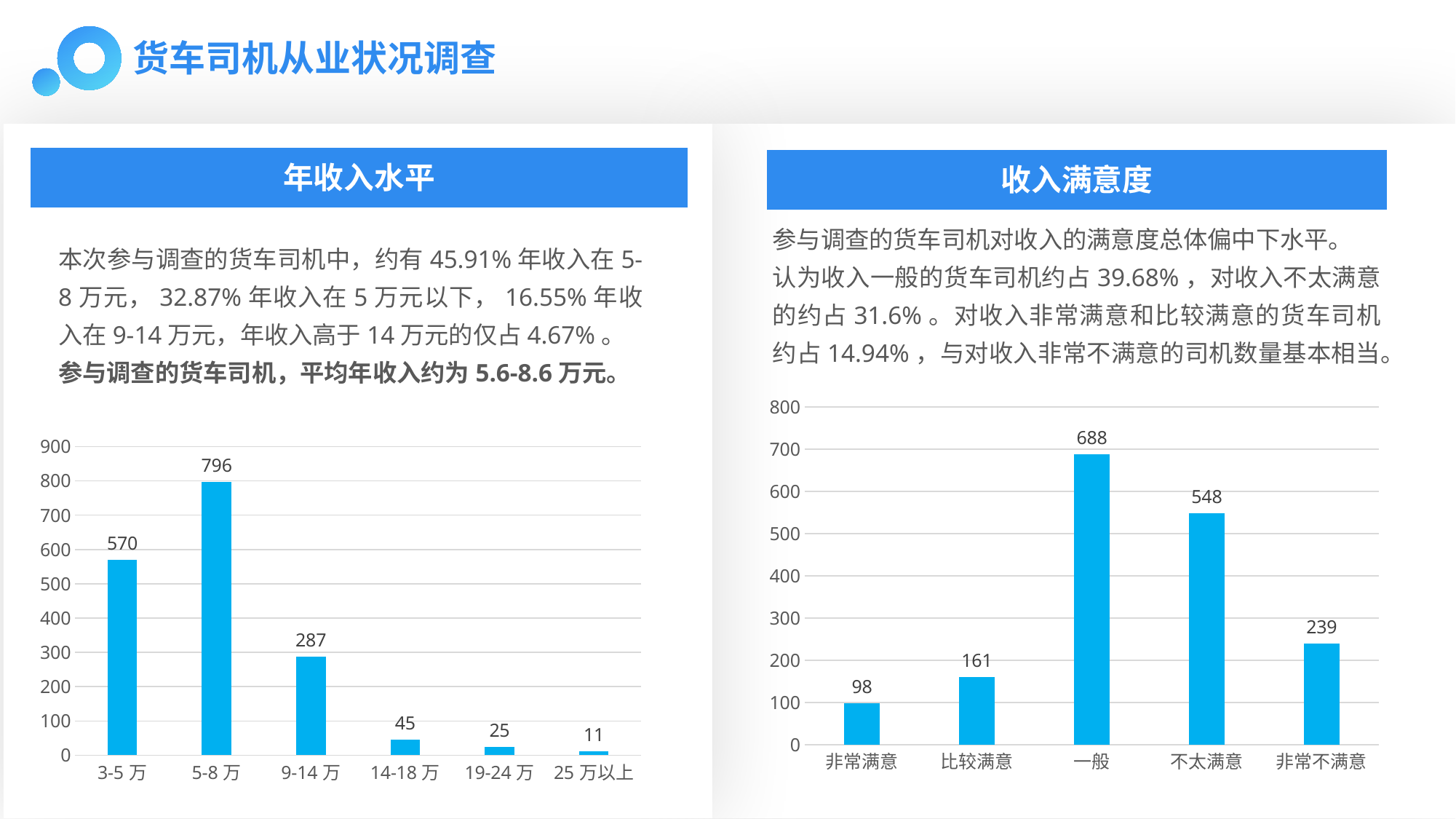
In the 收入满意度 chart, what is the value for 非常不满意? 239 In the 年收入水平 chart, what is the difference between the values for 3-5 万 and 9-14 万? 283 In the 收入满意度 chart, which category has the highest value? 一般 What kind of chart is the 收入满意度 chart? bar chart In the 年收入水平 chart, what is the value for 14-18 万? 45 In the 年收入水平 chart, do the values rise or fall from 5-8 万 to 25 万以上? fall In the 收入满意度 chart, how many categories are shown on the x axis? 5 In the 收入满意度 chart, which is larger, the value for 比较满意 or the value for 非常不满意? 非常不满意 In the 收入满意度 chart, what is the difference between the values for 一般 and 不太满意? 140 In the 年收入水平 chart, what is the value for 5-8 万? 796 In the 年收入水平 chart, how many categories are shown on the x axis? 6 In the 年收入水平 chart, which category has the lowest value? 25 万以上